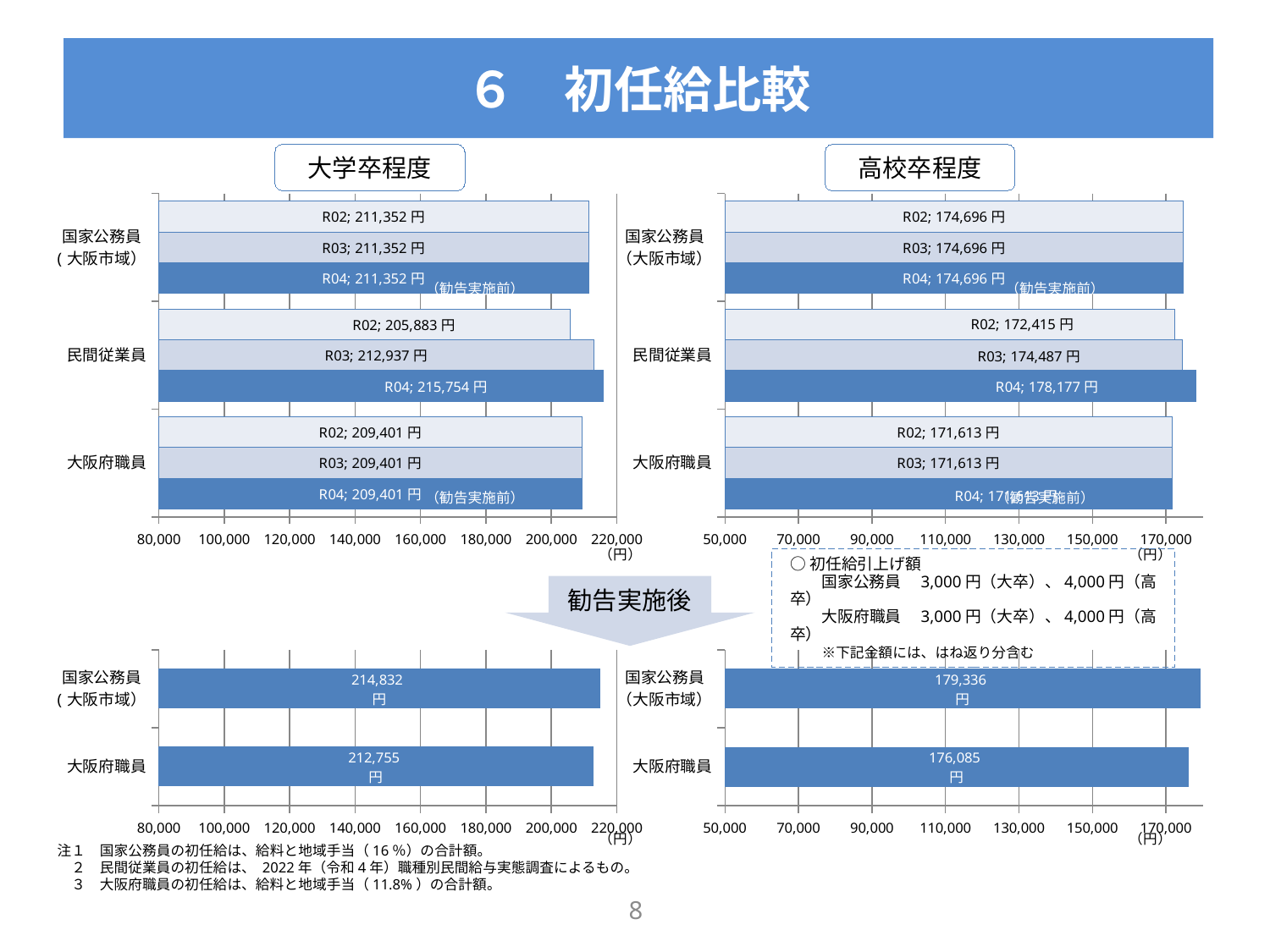
大学卒程度の上のグラフで、民間従業員のR04の値はいくらですか？ 215,754 円 勧告実施後の高校卒程度のグラフ（右下）で、国家公務員（大阪市域）と大阪府職員の差はいくらですか？ 3,251 円 高校卒程度の上のグラフで、民間従業員のR02の値は170,000より大きいですか、小さいですか？ 大きい 勧告実施後の大学卒程度のグラフ（左下）で、大阪府職員の値はいくらですか？ 212,755 円 高校卒程度の上のグラフで、民間従業員のR04と国家公務員（大阪市域）のR04ではどちらが大きいですか？ 民間従業員 高校卒程度の上のグラフで、国家公務員（大阪市域）のR02の値はいくらですか？ 174,696 円 大学卒程度の上のグラフで、大阪府職員のR03の値はいくらですか？ 209,401 円 勧告実施後の高校卒程度のグラフ（右下）で、国家公務員（大阪市域）の値はいくらですか？ 179,336 円 大学卒程度の上のグラフで、民間従業員の値はR02からR04にかけて増加していますか、減少していますか？ 増加 大学卒程度の上のグラフはどの種類のグラフですか？ 棒グラフ 勧告実施後の大学卒程度のグラフ（左下）には、いくつのカテゴリがありますか？ 2 大学卒程度の上のグラフで、民間従業員のR04とR02の差はいくらですか？ 9,871 円